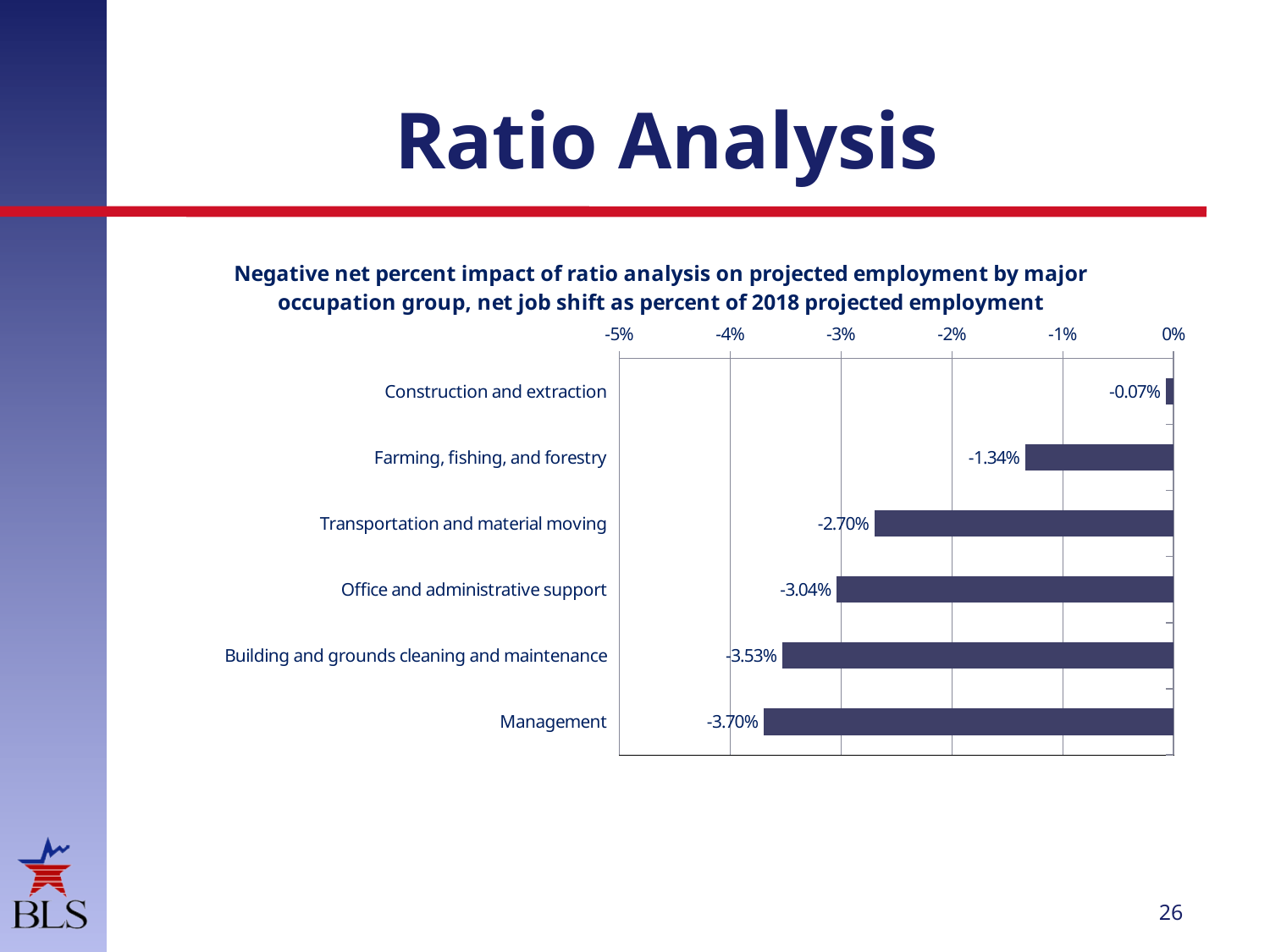
Which occupation group has the most negative value? Management What kind of chart is shown on the slide? bar chart What is the value for Construction and extraction? -0.07% What is the value for Farming, fishing, and forestry? -1.34% Which has a more negative value, Transportation and material moving or Office and administrative support? Office and administrative support What is the difference between the values for Management and Building and grounds cleaning and maintenance? 0.17% Which occupation group has the value closest to zero? Construction and extraction How many occupation groups are shown in the chart? 6 Is the value for Building and grounds cleaning and maintenance greater or less than -3%? less What is the value for Management? -3.70% What is the value of the leftmost tick on the horizontal axis? -5% What is the value for Office and administrative support? -3.04%